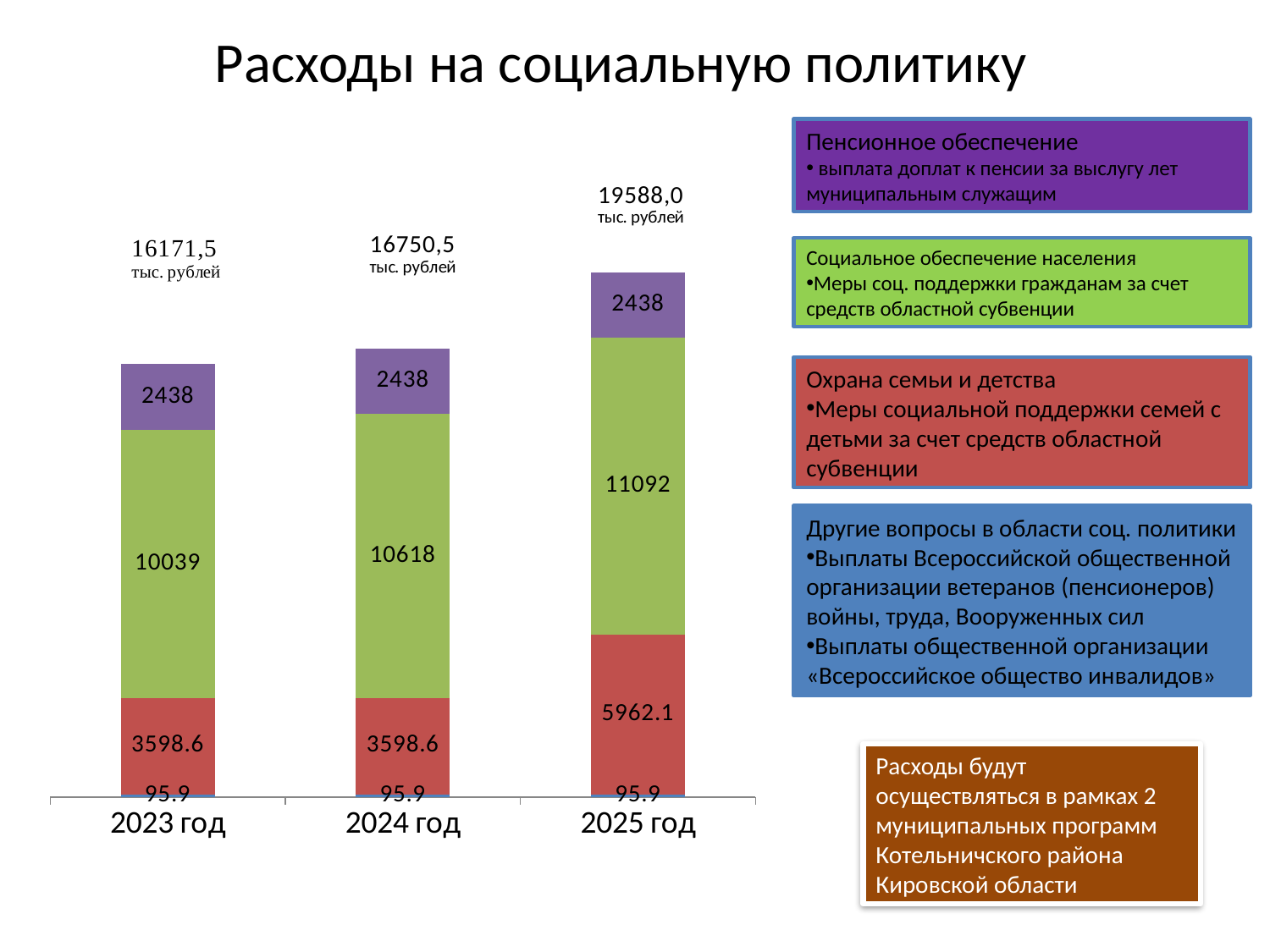
What is the total shown above the bar for 2023 год? 16171,5 тыс. рублей Which year has the lowest total expenditure? 2023 год What is the total shown above the bar for 2025 год? 19588,0 тыс. рублей What is the value of the green segment (Социальное обеспечение населения) for 2024 год? 10618 What is the value of the purple segment (Пенсионное обеспечение) for 2023 год? 2438 Which year has the highest total expenditure? 2025 год Is the red segment (Охрана семьи и детства) larger in 2025 год or in 2024 год? 2025 год How many years (categories) are shown on the x axis of the chart? 3 What is the value of the red segment (Охрана семьи и детства) for 2025 год? 5962.1 Do the total expenditures rise or fall from 2023 год to 2025 год? rise What type of chart is shown on the slide? stacked bar chart What is the difference between the green segment values for 2025 год and 2023 год? 1053